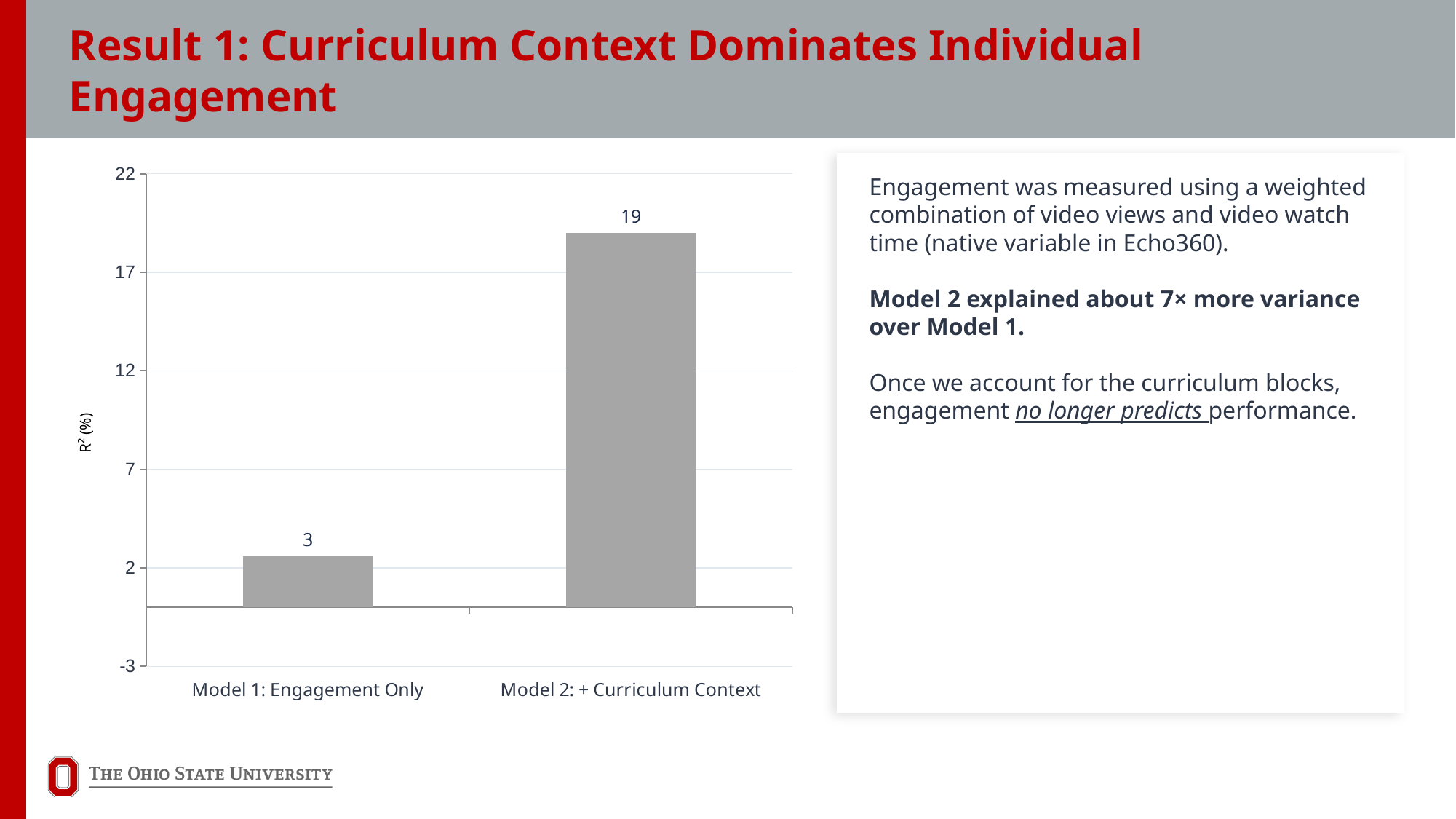
What colour are the bars in the chart? Grey What is the R² (%) value for Model 2: + Curriculum Context? 19 Which model has the lower R² (%)? Model 1: Engagement Only What is the label on the vertical axis of the chart? R² (%) Do the values rise or fall from Model 1 to Model 2 along the x axis? Rise What kind of chart is shown on the slide? Bar chart How many models (categories) are plotted in the chart? 2 Which model has the higher R² (%)? Model 2: + Curriculum Context What is the R² (%) value for Model 1: Engagement Only? 3 Is the R² (%) for Model 2: + Curriculum Context greater or less than 17? greater What is the difference in R² (%) between Model 2: + Curriculum Context and Model 1: Engagement Only? 16 Is the R² (%) for Model 1: Engagement Only greater or less than 7? less